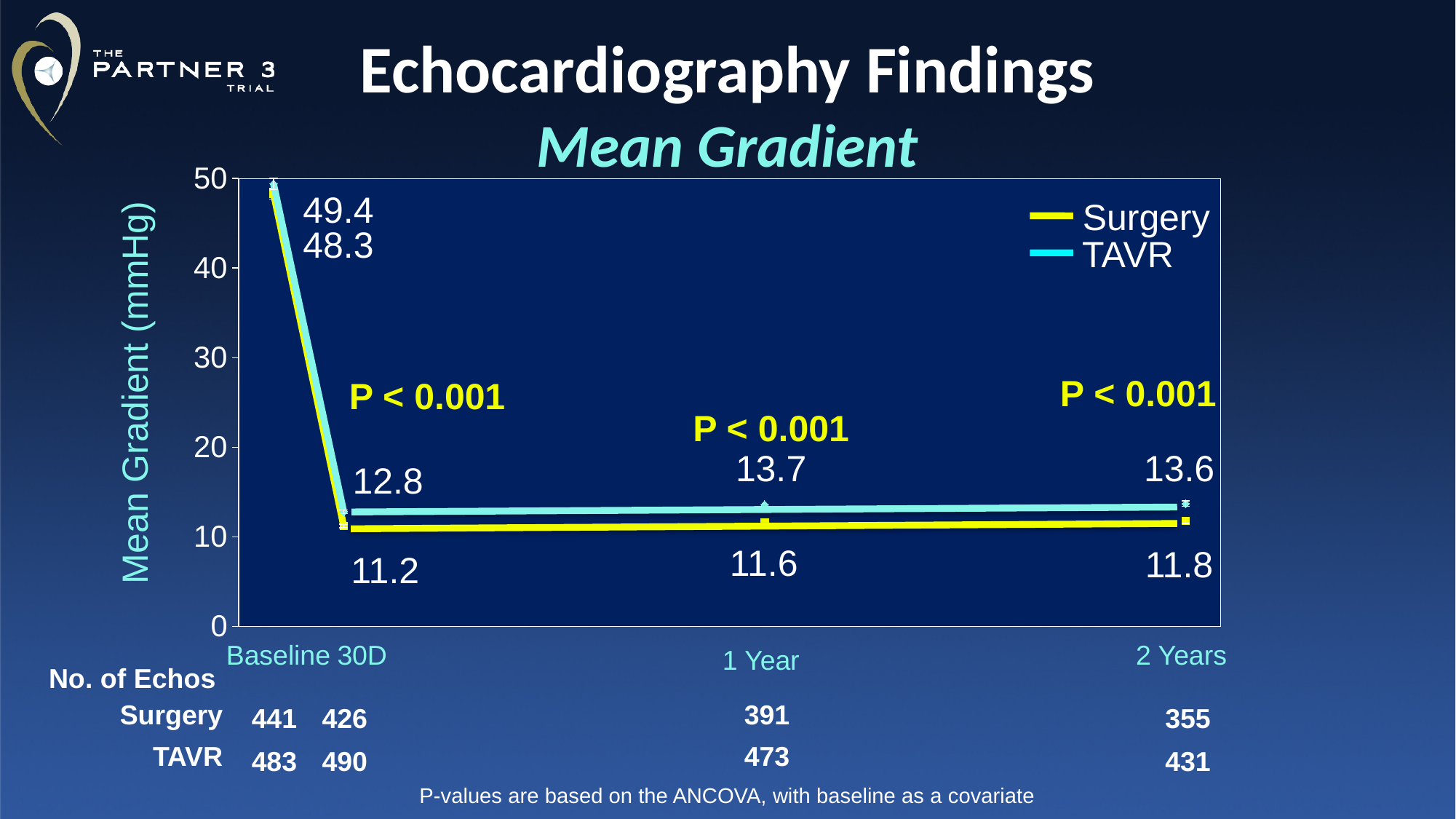
What is the difference between the TAVR and Surgery mean gradients at 30D? 1.6 How many series does the legend list? 2 What is the mean gradient for Surgery at 2 Years? 11.8 What kind of chart is shown on the slide? Line chart What is the mean gradient for TAVR at 30D? 12.8 What is the label on the y axis of the chart? Mean Gradient (mmHg) At 2 Years, which group has the higher mean gradient, Surgery or TAVR? TAVR At which time point is the Surgery mean gradient lowest? 30D What is the mean gradient for Surgery at 30D? 11.2 What is the difference between the TAVR and Surgery mean gradients at 1 Year? 2.1 Do the mean gradient values rise or fall from Baseline to 30D? Fall What is the mean gradient for TAVR at 1 Year? 13.7